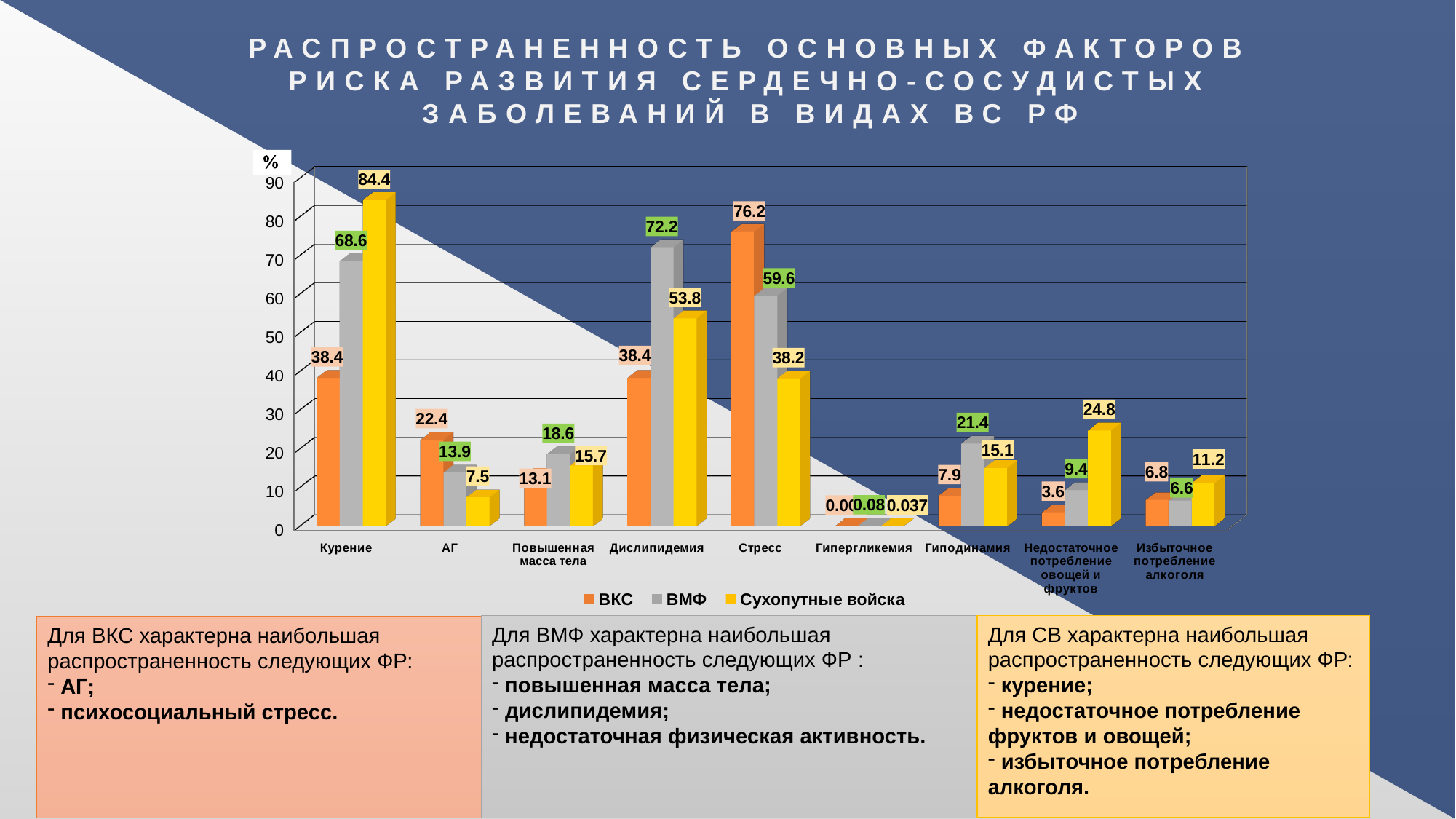
In the АГ category, which series has the larger value, ВКС or ВМФ? ВКС Which category has the lowest value for Сухопутные войска? Гипергликемия What is the value for ВКС in the Стресс category? 76.2 How many categories are shown on the x axis? 9 What is the value for Сухопутные войска in the Курение category? 84.4 What is the value for ВМФ in the Дислипидемия category? 72.2 What is the value for ВМФ in the Гиподинамия category? 21.4 How many series does the legend list? 3 What is the difference between the Сухопутные войска and ВКС values in the Курение category? 46.0 Which colour represents the Сухопутные войска series? yellow Which category has the highest value for ВКС? Стресс What kind of chart is shown on the slide? bar chart